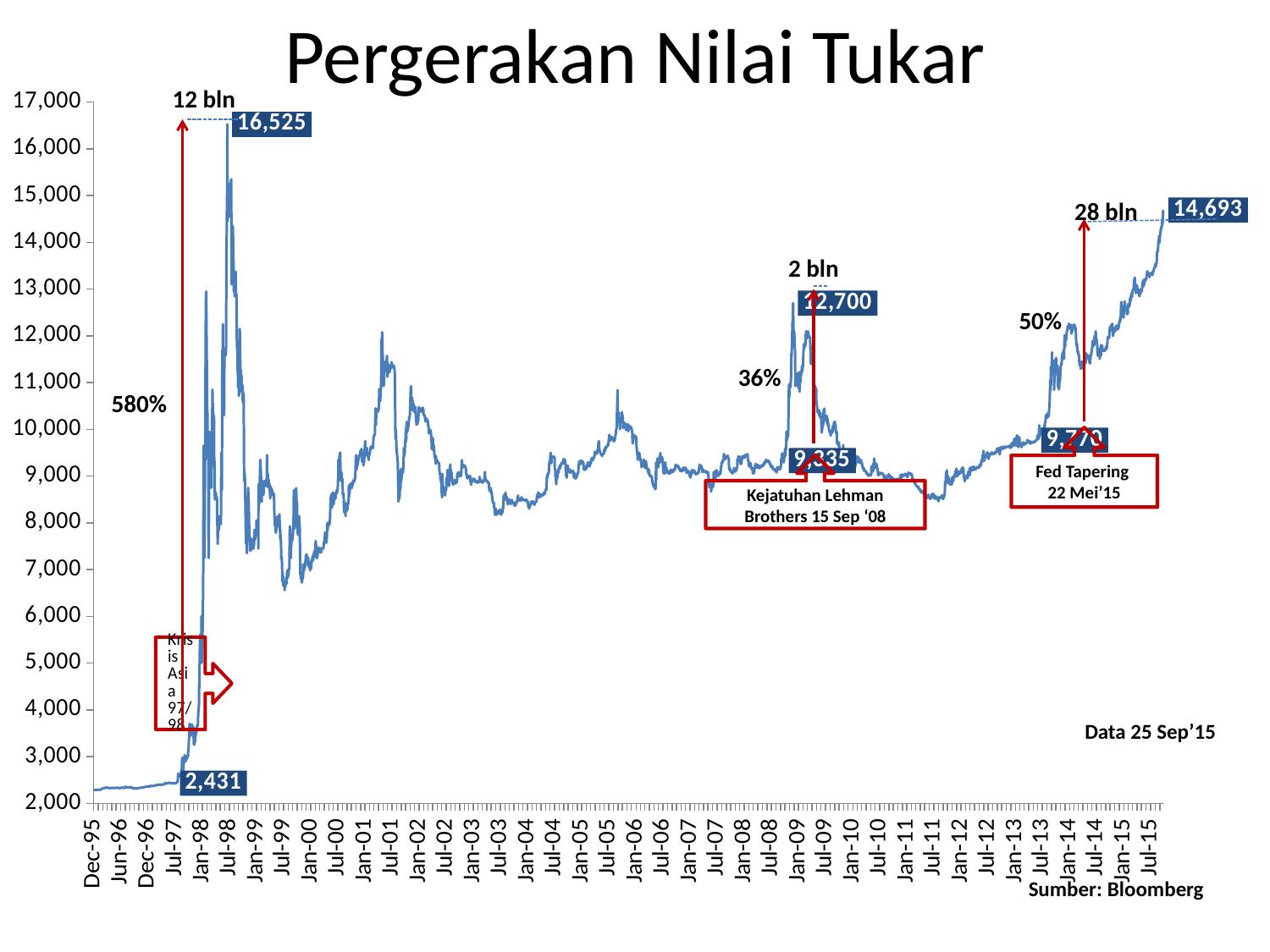
What is the title of the chart? Pergerakan Nilai Tukar What is the value labelled at the peak around 2009, after the Lehman Brothers collapse? 12,700 What is the value labelled at the end of the series (2015)? 14,693 Which labelled value on the chart is the lowest? 2,431 What is the difference between the 1998 peak (16,525) and the starting value (2,431)? 14,094 What is the value labelled at the start of the series, before the 1997/98 crisis? 2,431 What is the peak value labelled on the chart around 1998? 16,525 Which is larger, the 1998 peak value or the 2015 end value? 1998 peak (16,525) Which labelled value on the chart is the highest? 16,525 Does the line rise or fall between Jan-14 and Jul-15? rise What kind of chart is shown on the slide? line chart Is the value around Jul-99 greater or less than 8,000? less